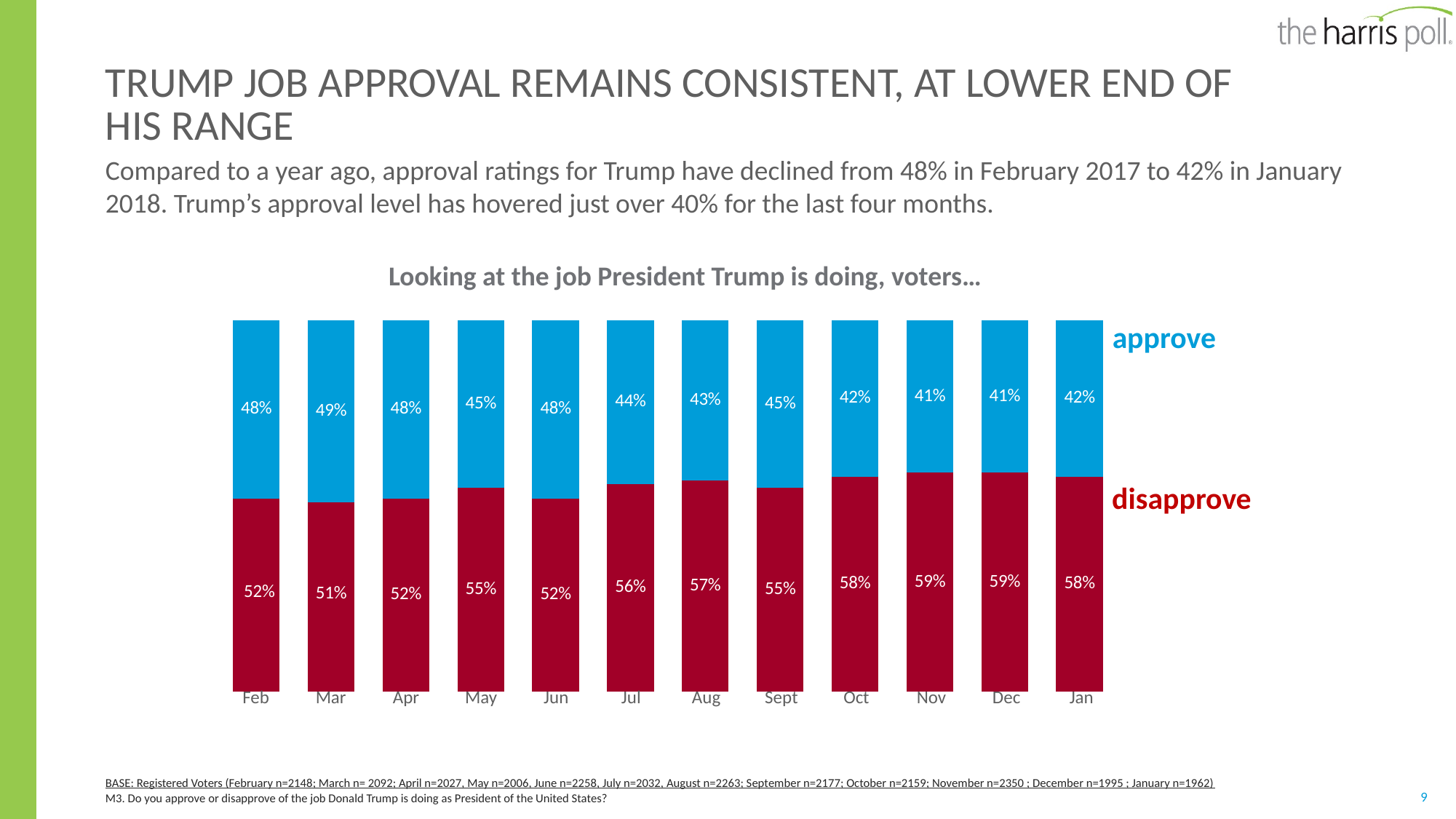
What is the total of the approve and disapprove values for Oct? 100% What is the approve value for Feb? 48% What is the approve value for Jan? 42% How many series does the chart show? 2 What is the disapprove value for Aug? 57% Which is larger, the approve value for May or the approve value for Jun? Jun Which month has the lowest disapprove value? Mar What is the difference between the disapprove value for Dec and the disapprove value for Feb? 7% Which month has the highest approve value? Mar Does the approve value generally rise or fall from Feb to Jan? Fall What kind of chart is shown on the slide? Stacked bar chart How many months are shown on the x axis? 12